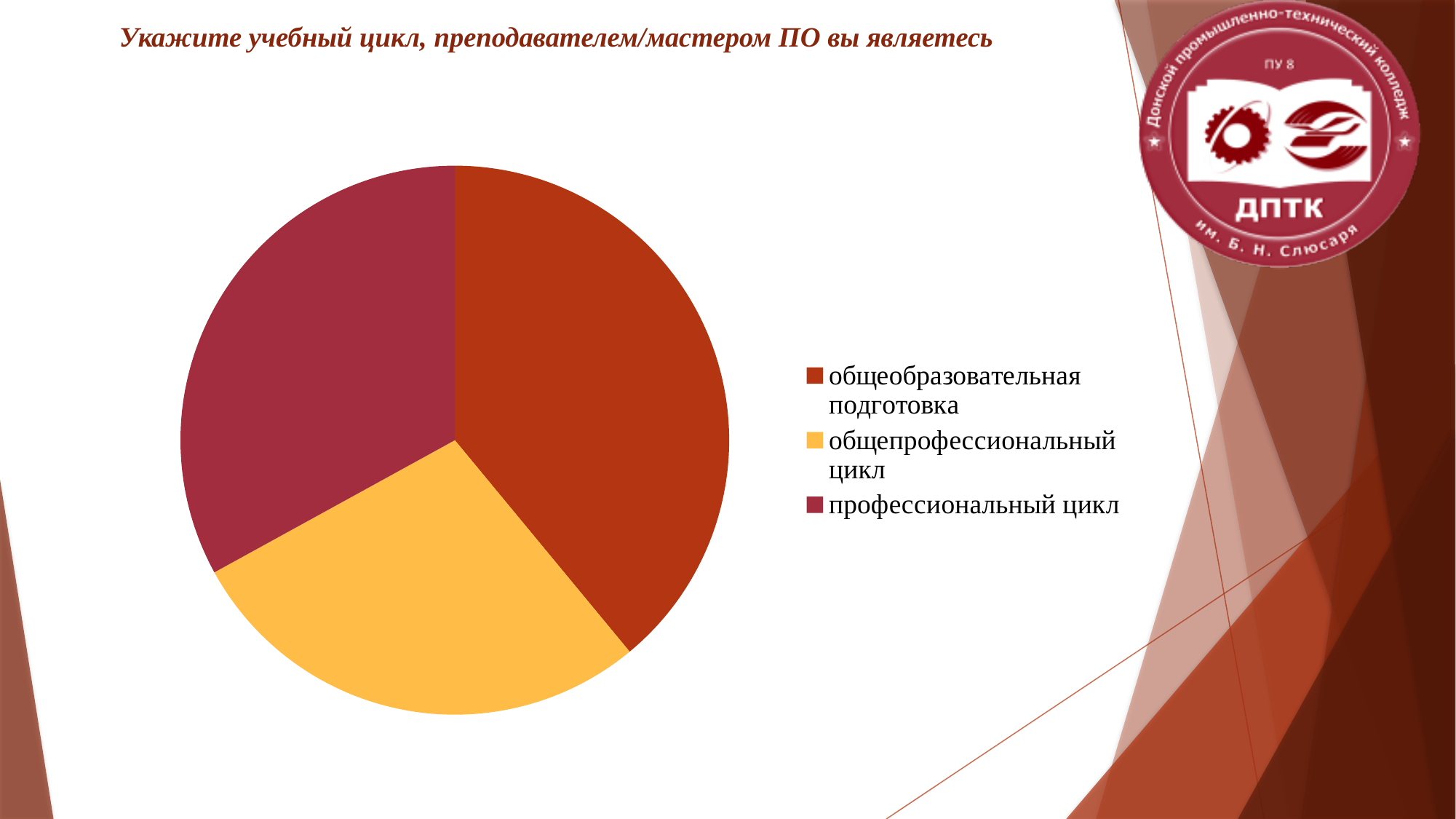
What is the title of the slide above the pie chart? Укажите учебный цикл, преподавателем/мастером ПО вы являетесь What kind of chart is shown on the slide? pie chart Which category has the largest slice in the pie chart? общеобразовательная подготовка Which slice is larger: профессиональный цикл or общепрофессиональный цикл? профессиональный цикл What colour is the slice for общепрофессиональный цикл? yellow How many entries does the legend of the pie chart list? 3 Which slice is larger: общеобразовательная подготовка or общепрофессиональный цикл? общеобразовательная подготовка How many slices does the pie chart have? 3 Which category has the smallest slice in the pie chart? общепрофессиональный цикл